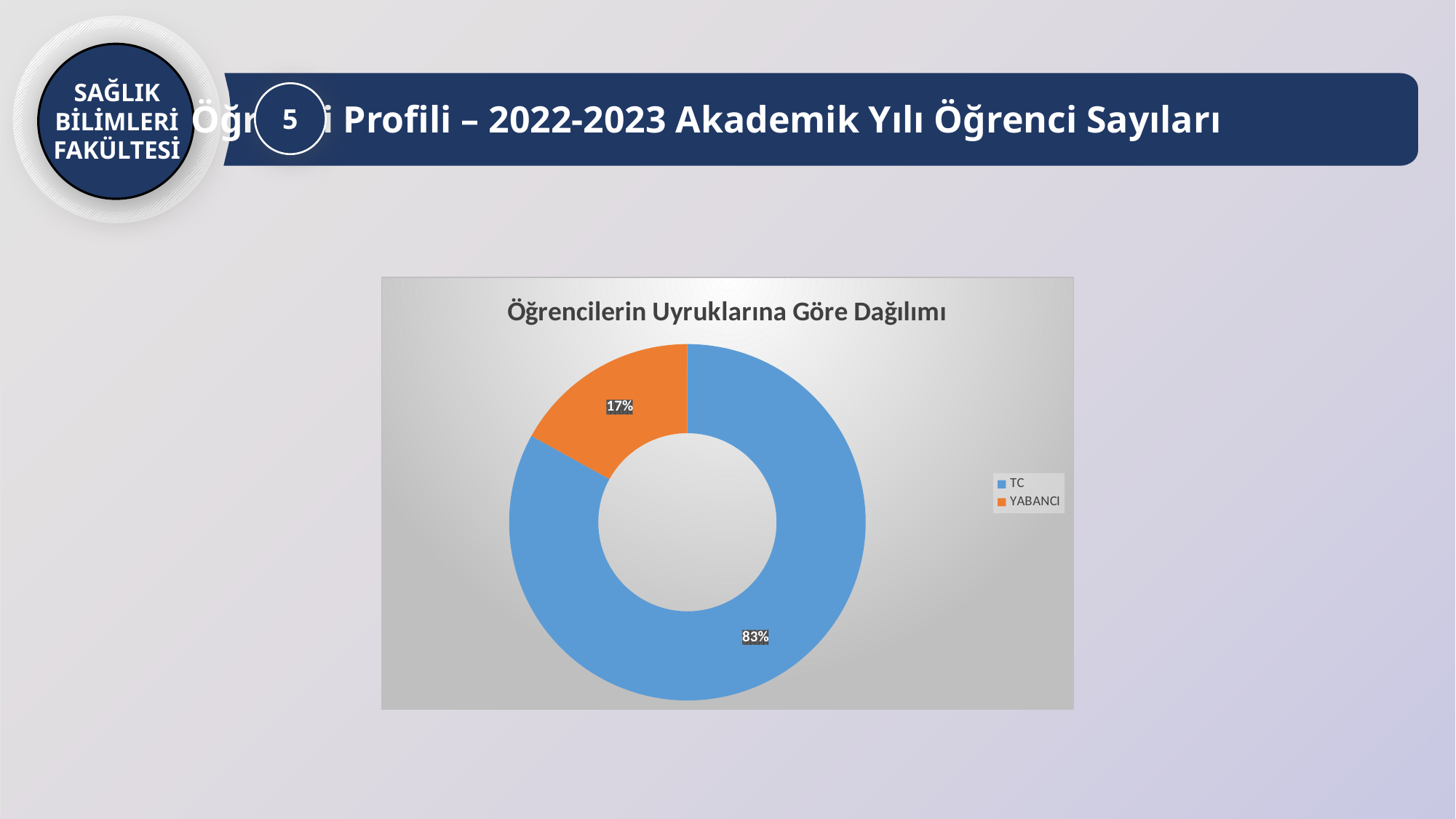
How many categories does the chart show? 2 Which category has the smallest share? YABANCI What share of students is labelled for TC? 83% How many entries does the legend list? 2 What colour represents YABANCI in the chart? Orange Which category has the largest share? TC What is the title of the chart? Öğrencilerin Uyruklarına Göre Dağılımı What is the difference in percentage points between the TC and YABANCI shares? 66 What share of students is labelled for YABANCI? 17% What kind of chart is shown on the slide? Doughnut (pie) chart Which is larger, the share for TC or the share for YABANCI? TC What is the total of the two labelled shares? 100%